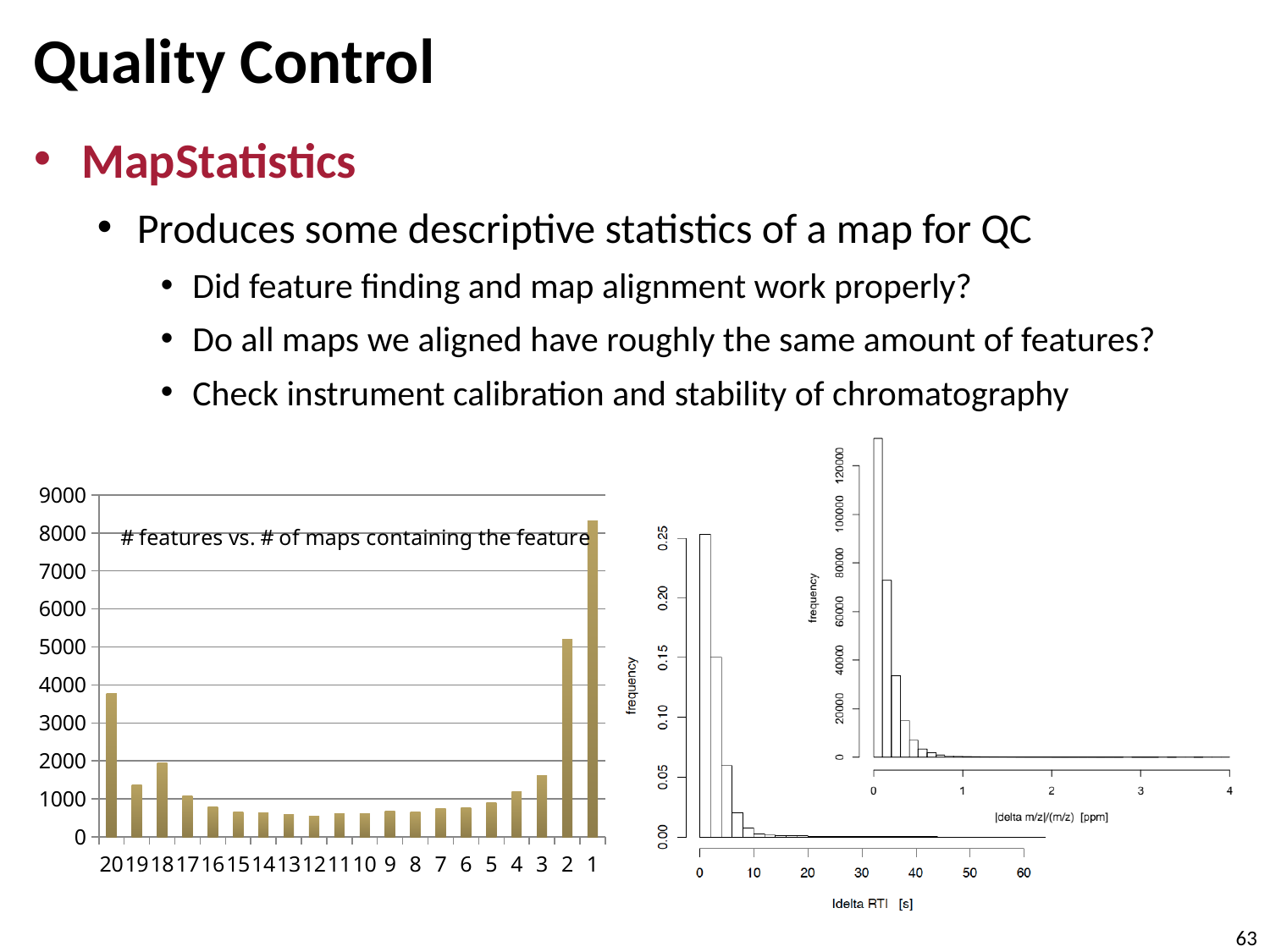
In the '# features vs. # of maps containing the feature' chart, how many categories are shown on the x axis? 20 In the '# features vs. # of maps containing the feature' chart, is the value for category 1 greater or less than 8000? greater In the '# features vs. # of maps containing the feature' chart, is the value for category 3 greater or less than 1000? greater What is the x-axis label of the large histogram on the right of the slide? |delta RT| [s] In the '# features vs. # of maps containing the feature' chart, which category has the highest bar? 1 In the '# features vs. # of maps containing the feature' chart, is the value for category 20 greater or less than 4000? less What is the title of the bar chart on the left of the slide? # features vs. # of maps containing the feature What kind of chart is the '# features vs. # of maps containing the feature' chart? bar chart In the '# features vs. # of maps containing the feature' chart, which has the larger value, category 20 or category 2? 2 In the '# features vs. # of maps containing the feature' chart, which has the larger value, category 18 or category 19? 18